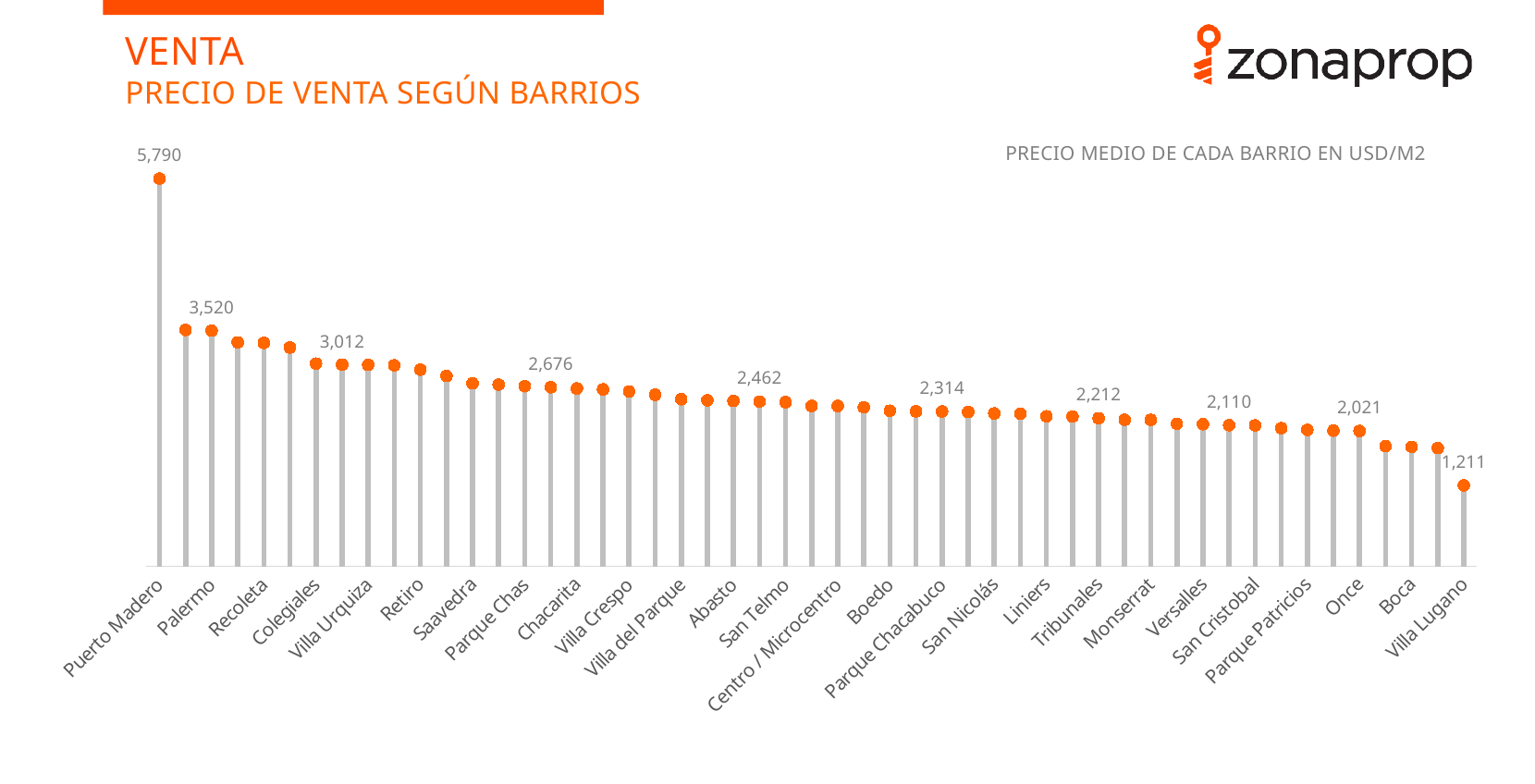
What is the title of the chart on the slide? PRECIO DE VENTA SEGÚN BARRIOS What is the average sale price shown for Puerto Madero? 5,790 Which barrio has the highest sale price in the chart? Puerto Madero Which has a higher sale price, Recoleta or Once? Recoleta Which has a higher sale price, Boca or Retiro? Retiro Do the values rise or fall moving from left to right along the x axis? fall What is the average sale price shown for Villa Lugano? 1,211 What is the difference between the sale price of Puerto Madero and that of Palermo? 2,270 What is the difference between the sale price of Puerto Madero and that of Villa Lugano? 4,579 Which barrio has the lowest sale price in the chart? Villa Lugano What is the average sale price shown for Palermo? 3,520 In what unit are the prices in the chart expressed, according to the note on the slide? USD/M2